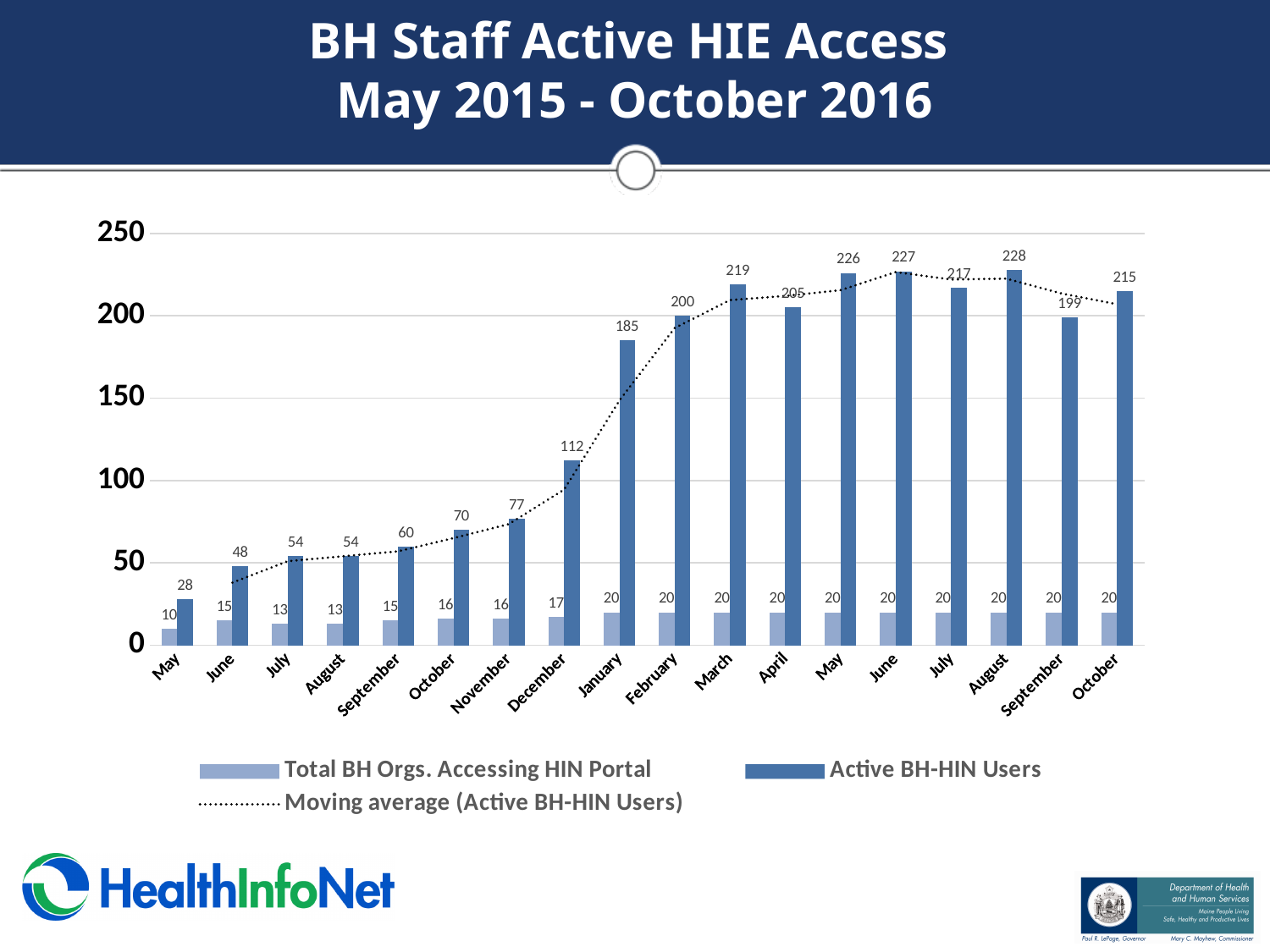
Do the Active BH-HIN Users values generally rise or fall from May 2015 to August 2016? rise Is the value of Active BH-HIN Users for February greater or less than 150? greater What is the value of Active BH-HIN Users for December? 112 How many months are shown on the x axis? 18 Which is larger, the Active BH-HIN Users value for March or for April? March Which month has the highest value for Active BH-HIN Users? August 2016 What is the value of Total BH Orgs. Accessing HIN Portal for May 2015 (the first May on the x axis)? 10 What is the value of Active BH-HIN Users for August 2016 (the second August on the x axis)? 228 What is the difference in Active BH-HIN Users between January and December? 73 What kind of chart is this? Bar chart with a moving average line How many series does the legend list? 3 Which month has the lowest value for Active BH-HIN Users? May 2015